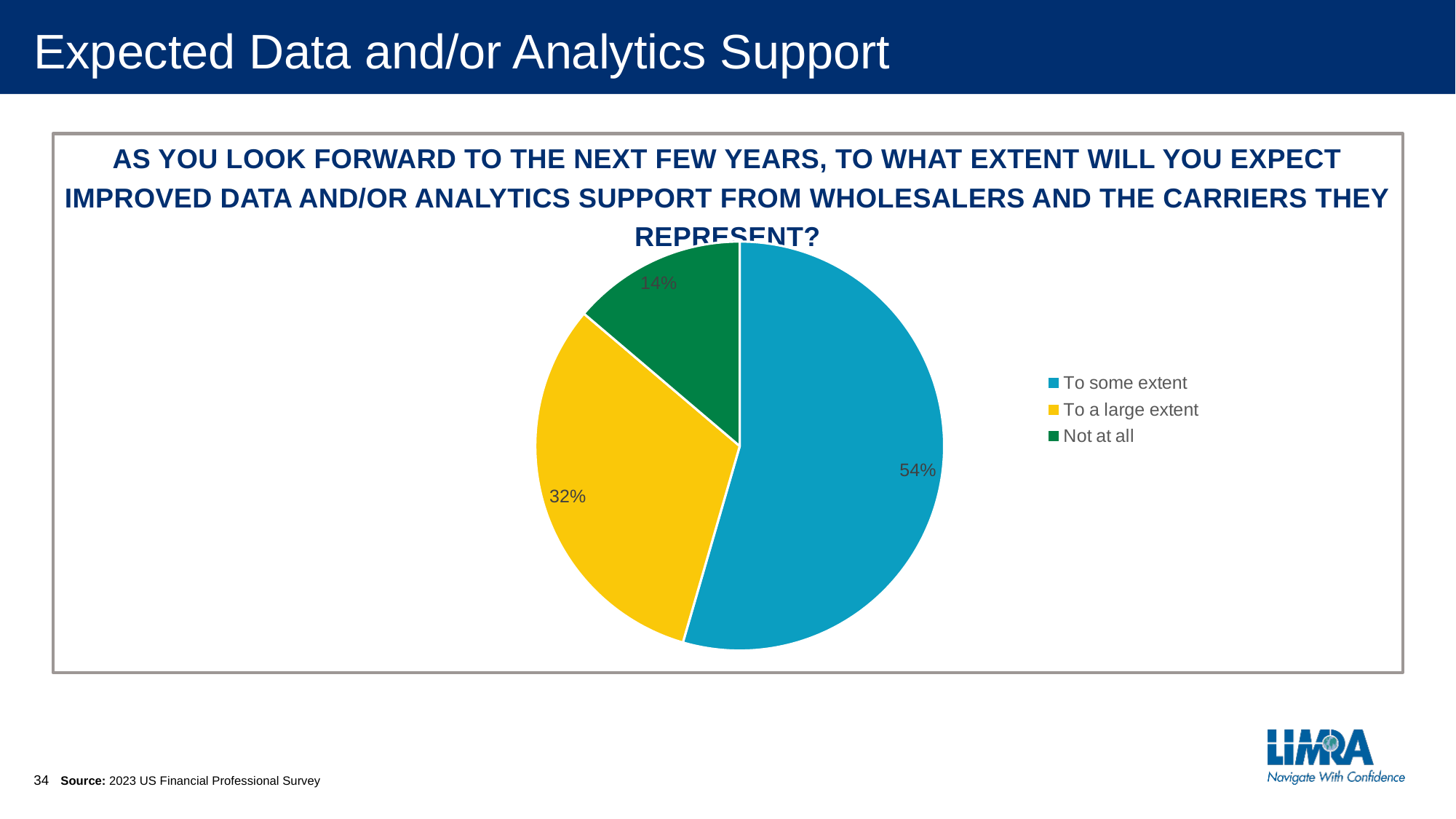
Which response has the smallest share of the pie? Not at all What colour is the "Not at all" slice? Green How many entries does the legend list? 3 What kind of chart is shown on the slide? Pie chart What is the difference in percentage points between "To some extent" and "To a large extent"? 22 What percentage of respondents answered "Not at all"? 14% How many slices does the pie chart have? 3 What is the difference in percentage points between "To a large extent" and "Not at all"? 18 What percentage of respondents answered "To a large extent"? 32% What percentage of respondents answered "To some extent"? 54% Which response has the largest share of the pie? To some extent Which is larger: the share for "To a large extent" or the share for "Not at all"? To a large extent